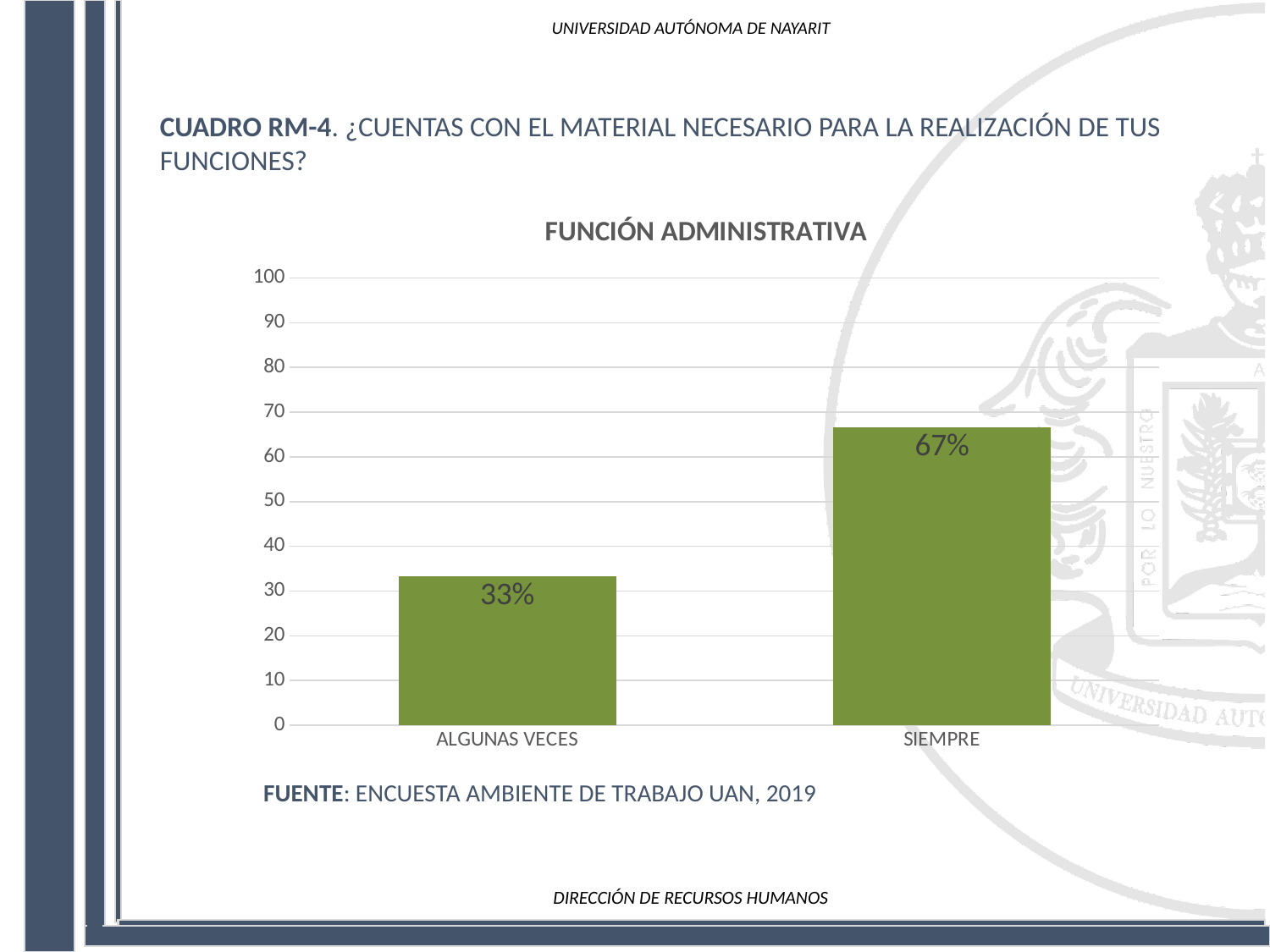
What kind of chart is shown on the slide? Bar chart What is the value for ALGUNAS VECES? 33% What is the difference between the values for SIEMPRE and ALGUNAS VECES? 34% Which is larger, the value for ALGUNAS VECES or the value for SIEMPRE? SIEMPRE What is the highest value shown on the vertical axis? 100 How many categories are shown on the x axis? 2 Is the value for ALGUNAS VECES greater or less than 40? less Which category has the highest value? SIEMPRE Which category has the lowest value? ALGUNAS VECES What is the title of the chart? FUNCIÓN ADMINISTRATIVA What is the value for SIEMPRE? 67% Is the value for SIEMPRE greater or less than 50? greater